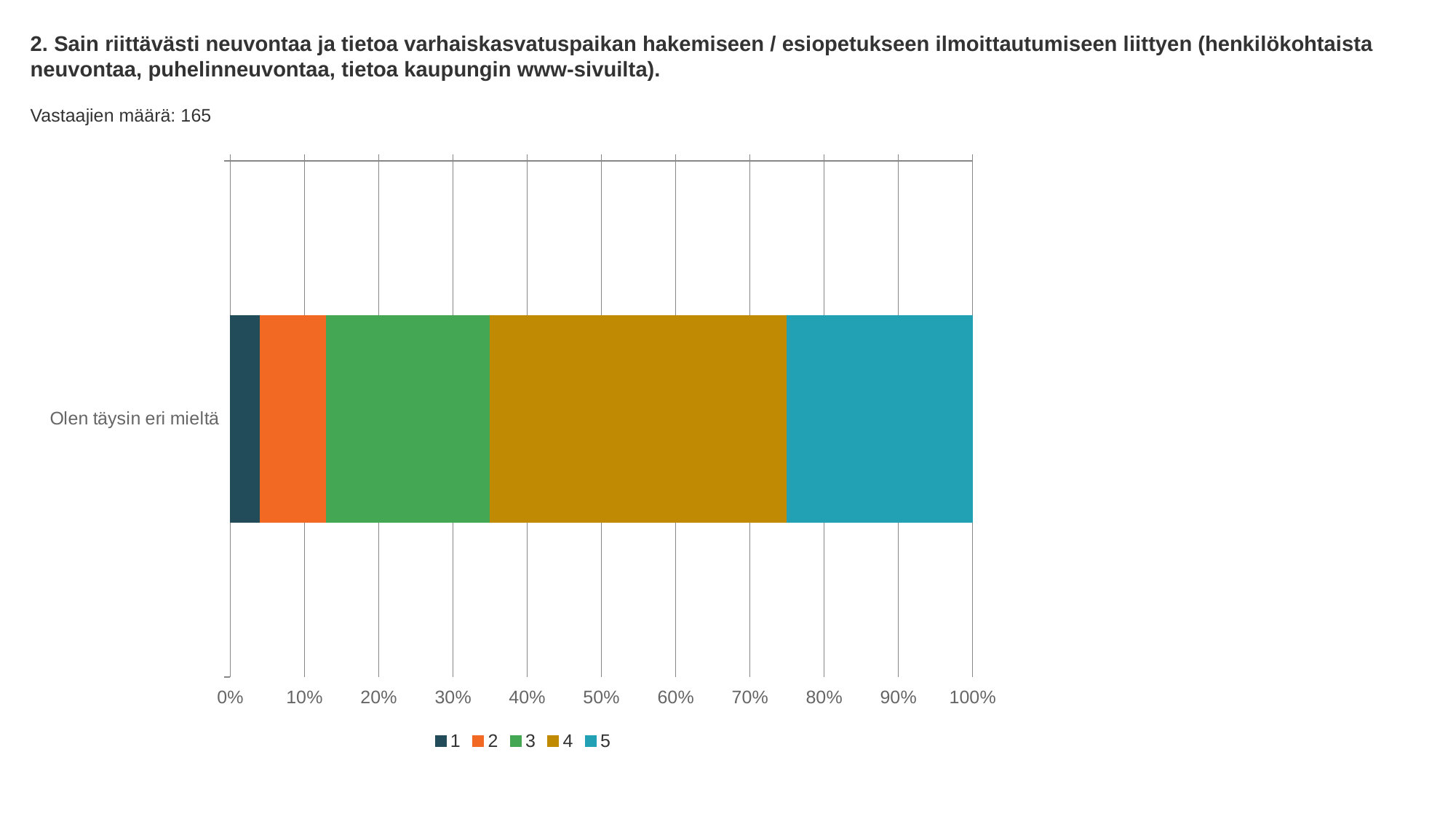
What is the category label shown on the y axis of the chart? Olen täysin eri mieltä What kind of chart is shown on the slide? Stacked bar chart Which series occupies the largest share of the bar? 4 Which series occupies the smallest share of the bar? 1 What is the number of respondents (Vastaajien määrä) stated on the slide? 165 Is the share of series 1 greater or less than 10%? less Is the share of series 4 greater or less than 30%? greater Which series has a larger share of the bar, 4 or 5? 4 Is the share of series 5 greater or less than 20%? greater Which series has a larger share of the bar, 2 or 3? 3 How many bars (categories) are plotted in the chart? 1 How many series does the legend list? 5